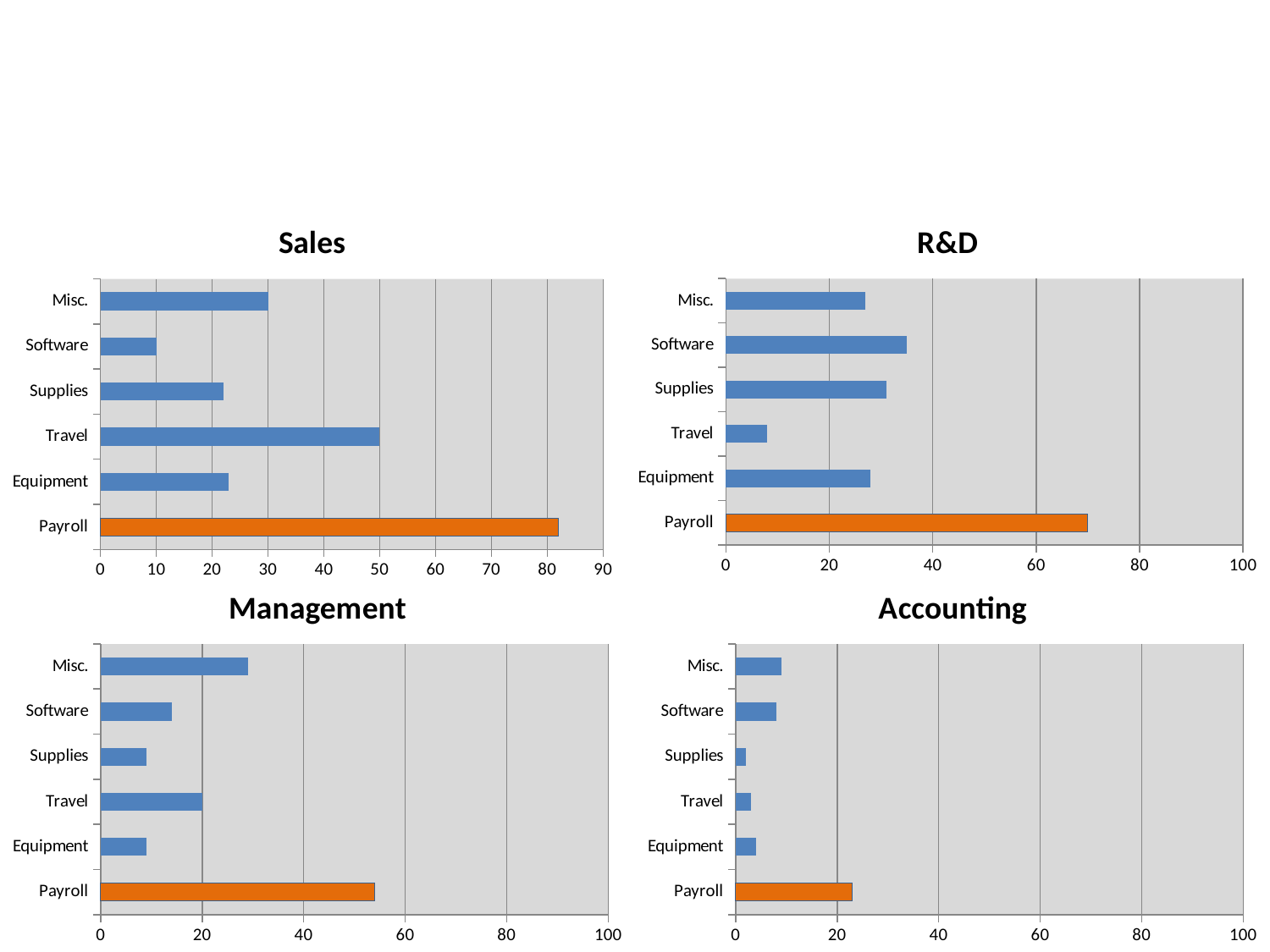
In the Accounting chart, which category has the highest value? Payroll In the Sales chart, which category has the highest value? Payroll In the Sales chart, what is the value for Travel? 50 In the Accounting chart, is the value for Supplies greater or less than 10? less In the Sales chart, is the value for Payroll greater or less than 80? greater How many categories are shown in the R&D chart? 6 In the R&D chart, which is larger, Software or Misc.? Software In the R&D chart, which category has the lowest value? Travel In the Sales chart, which category has the lowest value? Software What kind of chart is the Sales chart? bar chart